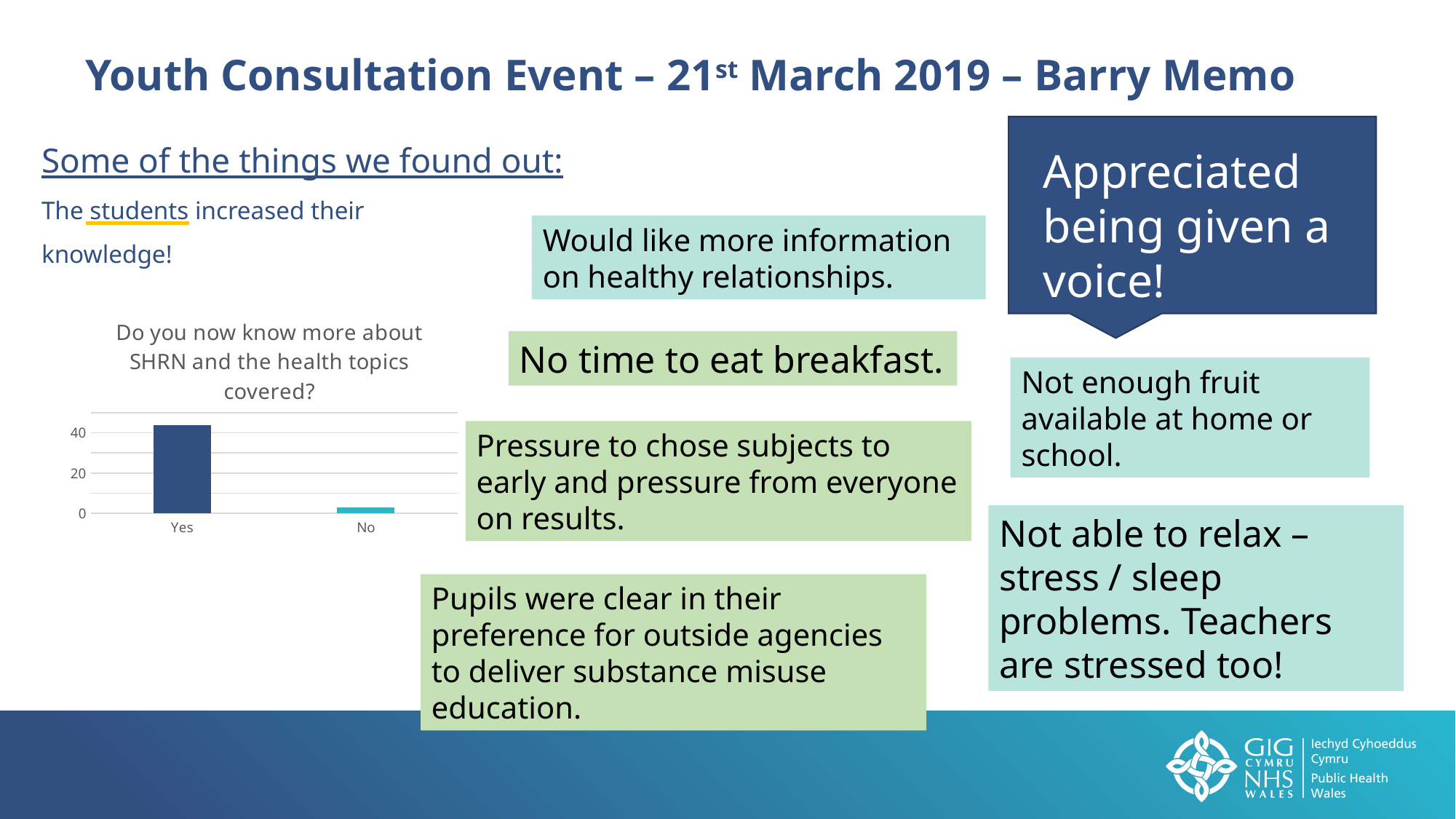
Which category has the highest bar in the chart? Yes What kind of chart is shown on the slide? bar chart What is the title of the chart? Do you now know more about SHRN and the health topics covered? Which category has the lowest bar in the chart? No How many categories are shown on the x axis of the chart? 2 Is the value for No greater or less than 20? less Which is larger in the chart, the value for Yes or the value for No? Yes Is the value for Yes greater or less than 20? greater Do the values rise or fall moving from Yes to No along the x axis? fall What is the highest value labelled on the chart's y axis? 40